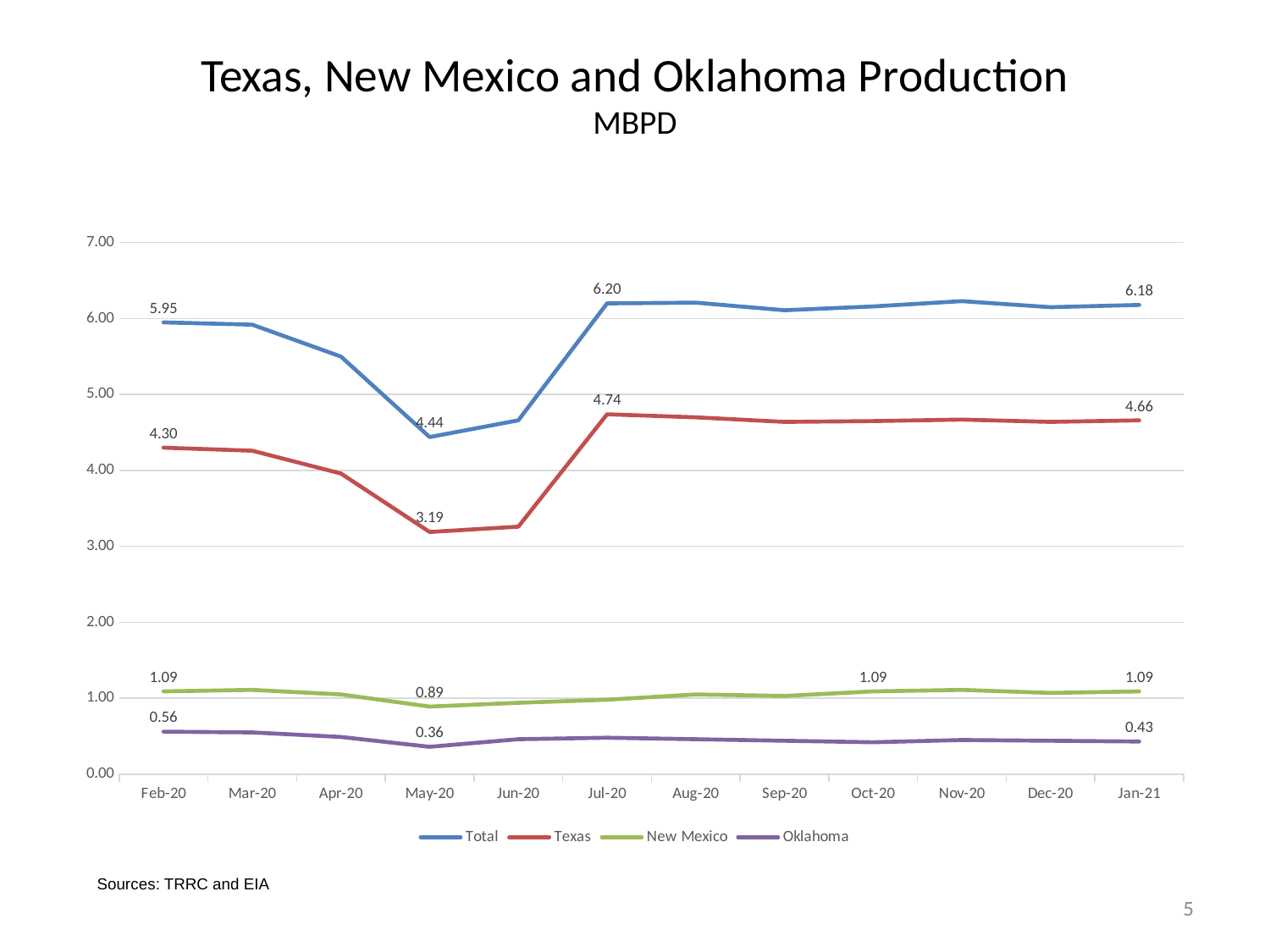
Is the Texas value for Jun-20 greater or less than 4.00? less How many months are shown on the x axis? 12 What is the New Mexico production value for May-20? 0.89 What is the Texas production value for May-20? 3.19 What is the difference between the Total value in Jul-20 and the Total value in May-20? 1.76 What is the Total production value for Feb-20? 5.95 How many series does the legend list? 4 What is the Oklahoma production value for Jan-21? 0.43 Is the Total value for Apr-20 greater or less than 5.00? greater What kind of chart is shown on the slide? Line chart Which series has the lowest values across the chart? Oklahoma What is the difference between the Texas value in Feb-20 and the Texas value in May-20? 1.11